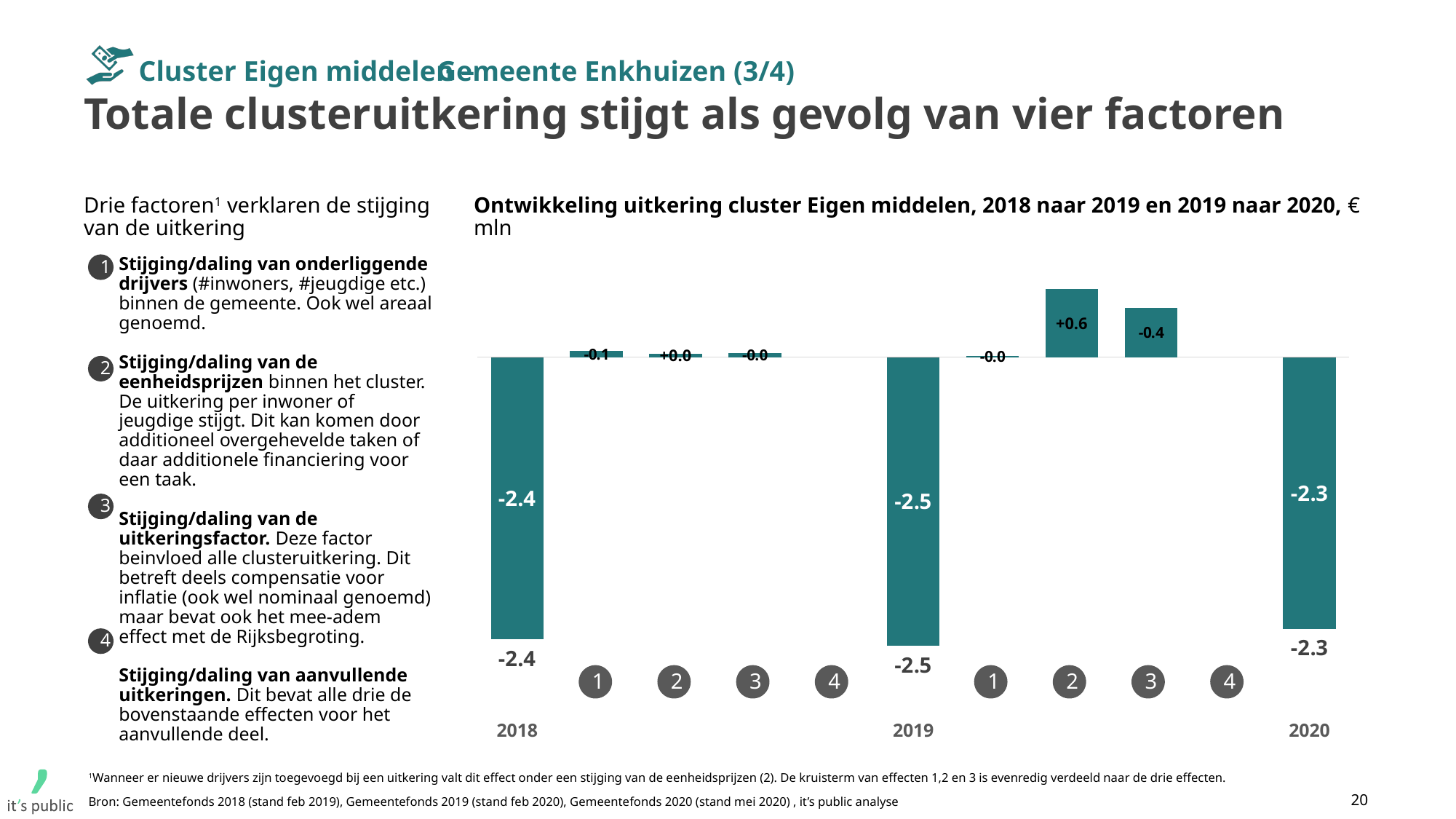
What is the value shown for 2019 in the chart? -2.5 In what unit are the values in the chart expressed? € mln What is the value shown for 2018 in the chart? -2.4 What is the value of factor 3 in the step from 2019 to 2020? -0.4 What is the value of factor 1 in the step from 2018 to 2019? -0.1 What type of chart is shown on the slide? Bar chart Which year has the highest total value in the chart? 2020 By how much does the total change from 2019 to 2020? 0.2 What is the value shown for 2020 in the chart? -2.3 Which factor has the largest positive effect in the step from 2019 to 2020? Factor 2 What is the value of factor 2 in the step from 2019 to 2020? +0.6 Which year has the lowest total value in the chart? 2019